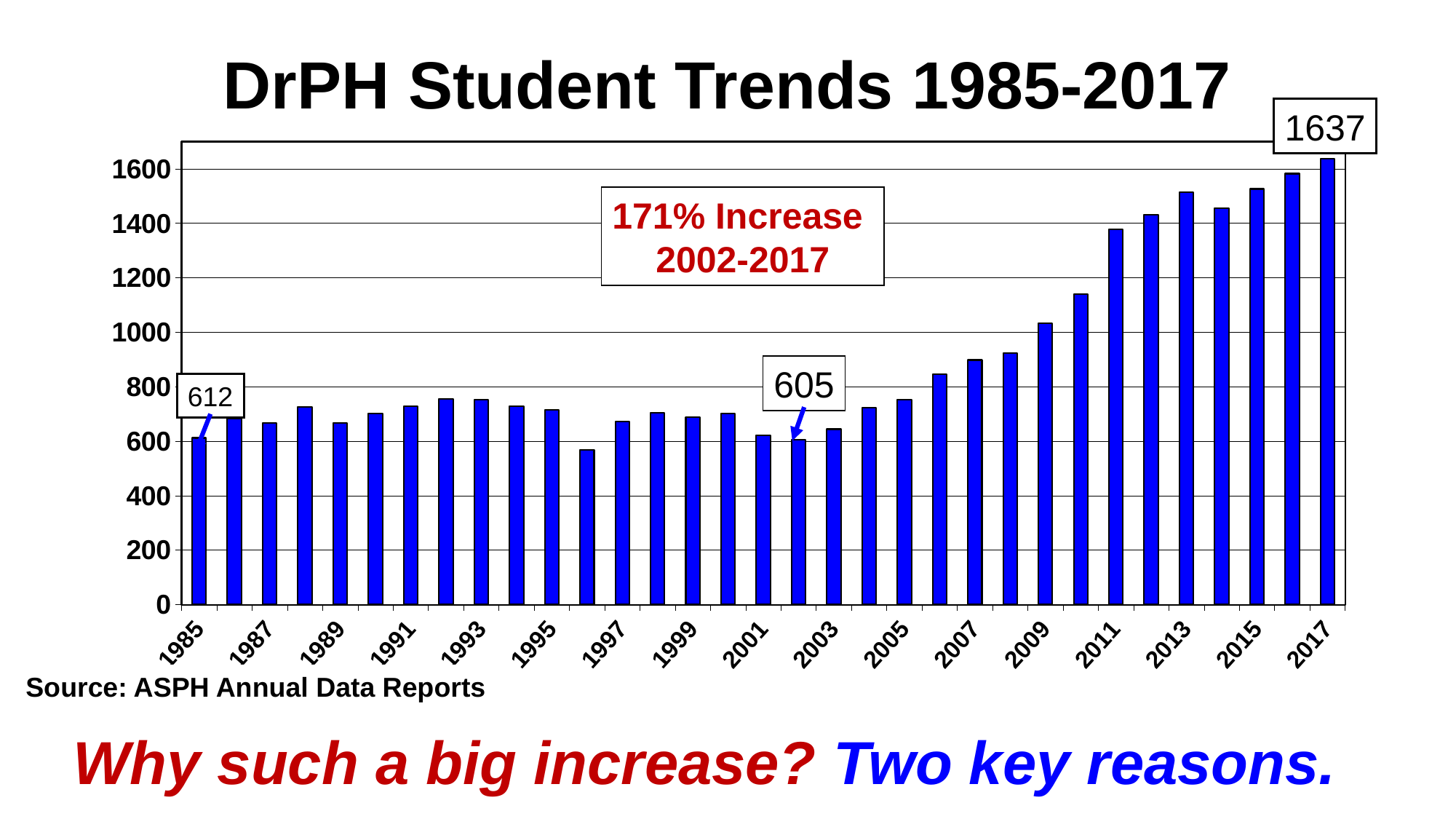
What is the value for 2002? 605 What is the value for 1985? 612 What is the value for 2017? 1637 What is the difference between the values for 2017 and 1985? 1025 Which is larger, the value for 1985 or the value for 2002? 1985 What percentage increase does the annotation on the chart report for 2002-2017? 171% Is the value for 2007 greater or less than 1000? less Is the value for 2011 greater or less than 1000? greater Is the value for 2013 greater or less than 1400? greater What is the difference between the values for 2017 and 2002? 1032 What kind of chart is shown on the slide? bar chart Which year has the highest value? 2017